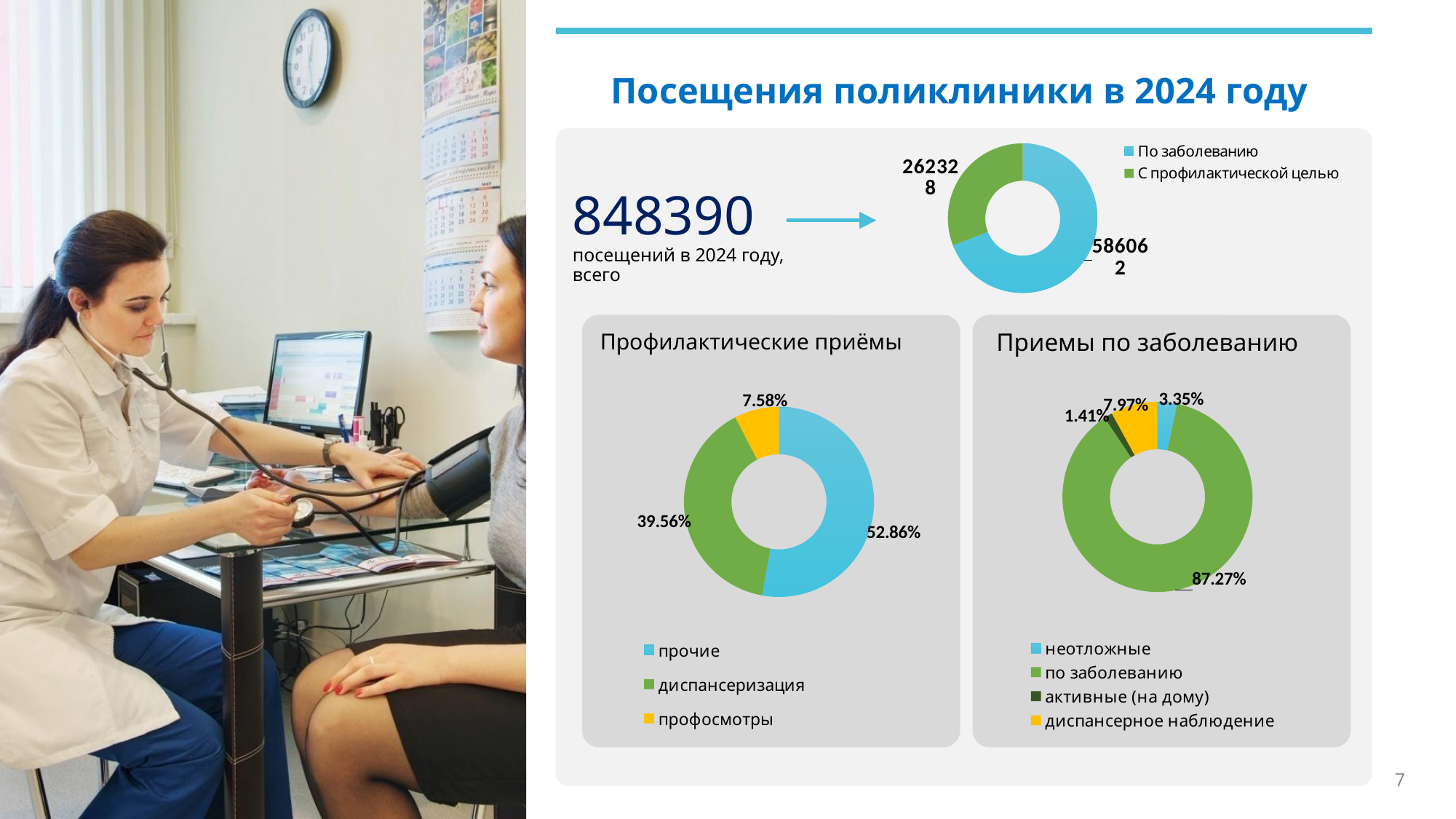
In the 'Приемы по заболеванию' chart, which category has the smallest share? активные (на дому) In the 'Профилактические приёмы' chart, how many categories are shown? 3 What type of chart is used for 'Приемы по заболеванию'? Donut (pie) chart In the top donut chart, which category is larger: 'По заболеванию' or 'С профилактической целью'? По заболеванию In the 'Профилактические приёмы' chart, which category has the smallest share? профосмотры In the 'Приемы по заболеванию' chart, what is the share for 'диспансерное наблюдение'? 7.97% In the top donut chart, what is the value for 'С профилактической целью'? 262328 In the 'Профилактические приёмы' chart, what is the share for 'диспансеризация'? 39.56% In the top donut chart, what is the difference between 'По заболеванию' and 'С профилактической целью'? 323734 In the 'Приемы по заболеванию' chart, how many categories does the legend list? 4 In the top donut chart, what is the value for 'По заболеванию'? 586062 In the 'Профилактические приёмы' chart, which category has the largest share? прочие